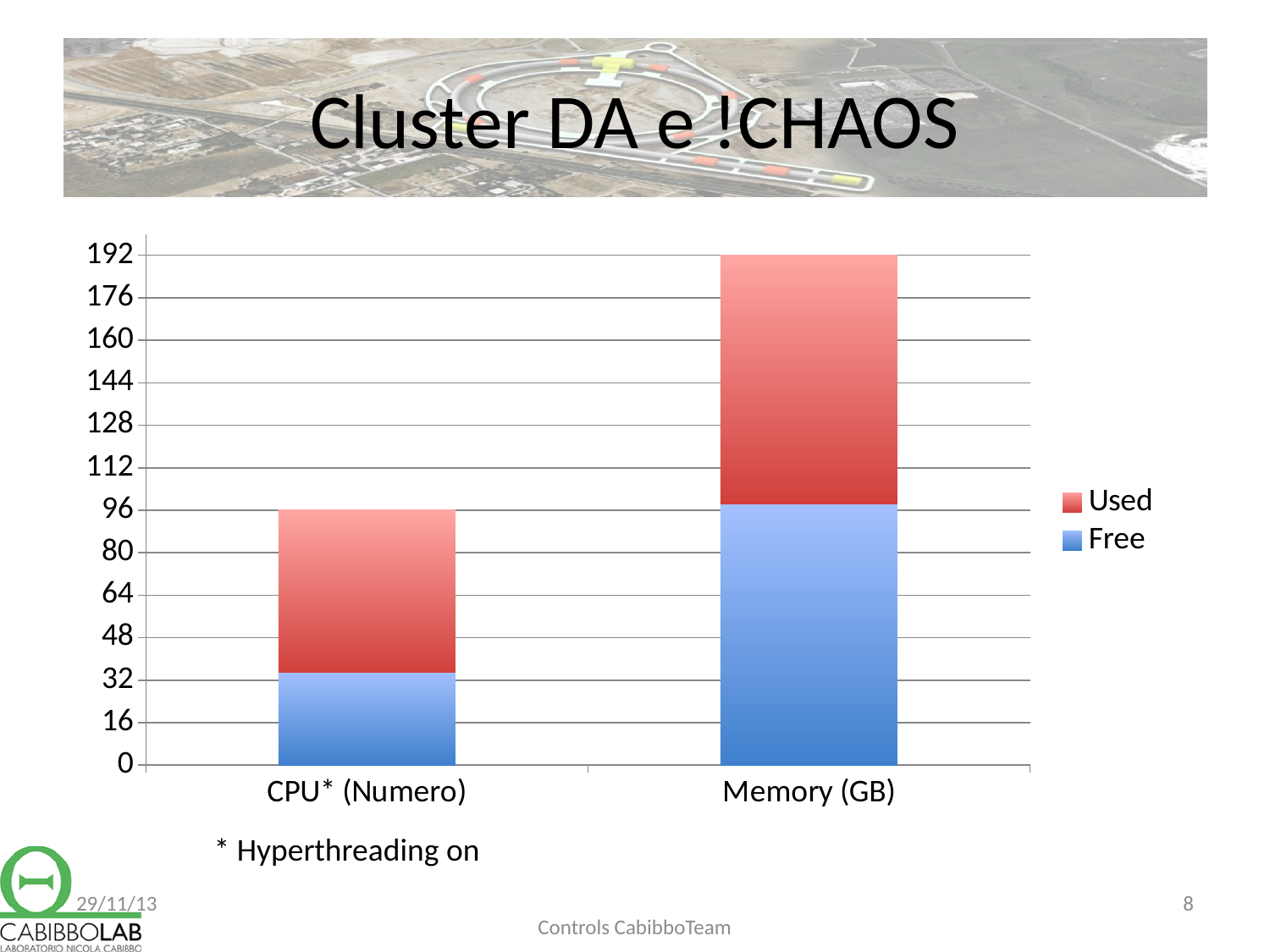
What is the total height of the stacked bar for CPU* (Numero)? 96 What is the total height of the stacked bar for Memory (GB)? 192 Is the Free value for Memory (GB) greater or less than 80? greater How many categories are shown on the x axis of the chart? 2 What are the two series listed in the chart's legend? Used and Free What kind of chart is shown on the slide? stacked bar chart Is the Free value for CPU* (Numero) greater or less than 48? less Which category has the taller stacked bar, CPU* (Numero) or Memory (GB)? Memory (GB) Is the Used value for CPU* (Numero) greater or less than 48? greater Which colour represents the Used series in the chart? red What is the difference between the total for Memory (GB) and the total for CPU* (Numero)? 96 How many series does the chart's legend list? 2